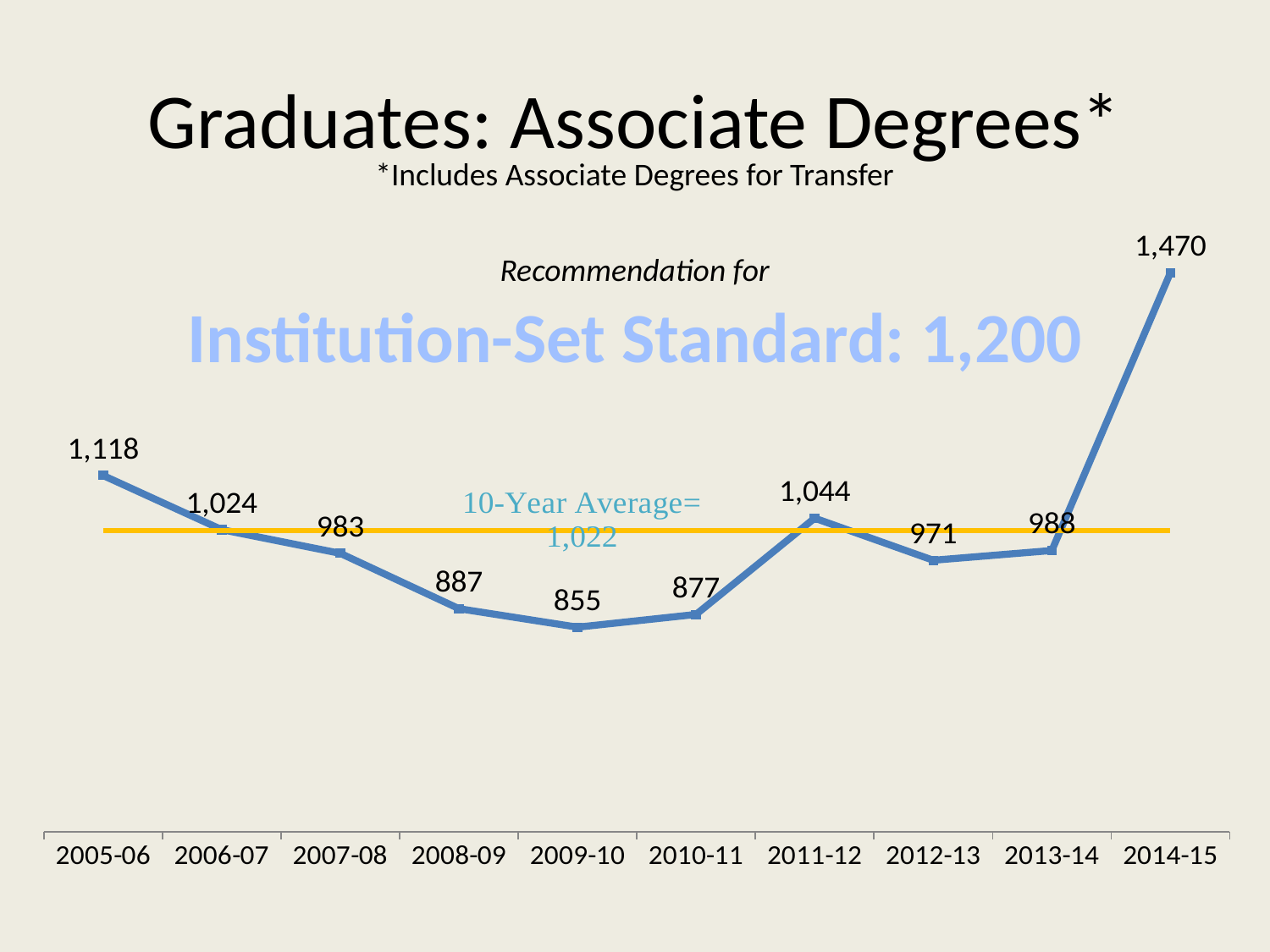
Which year has the lowest value? 2009-10 What is the difference between the values for 2014-15 and 2013-14? 482 Do the values rise or fall from 2005-06 to 2009-10? fall What is the value for 2014-15? 1,470 What is the 10-Year Average shown by the horizontal line? 1,022 What kind of chart is this? line chart How many years are plotted on the x axis? 10 What is the value for 2009-10? 855 Which is larger, the value for 2011-12 or the value for 2012-13? 2011-12 What is the value for 2005-06? 1,118 Which year has the highest value? 2014-15 What is the difference between the values for 2005-06 and 2006-07? 94